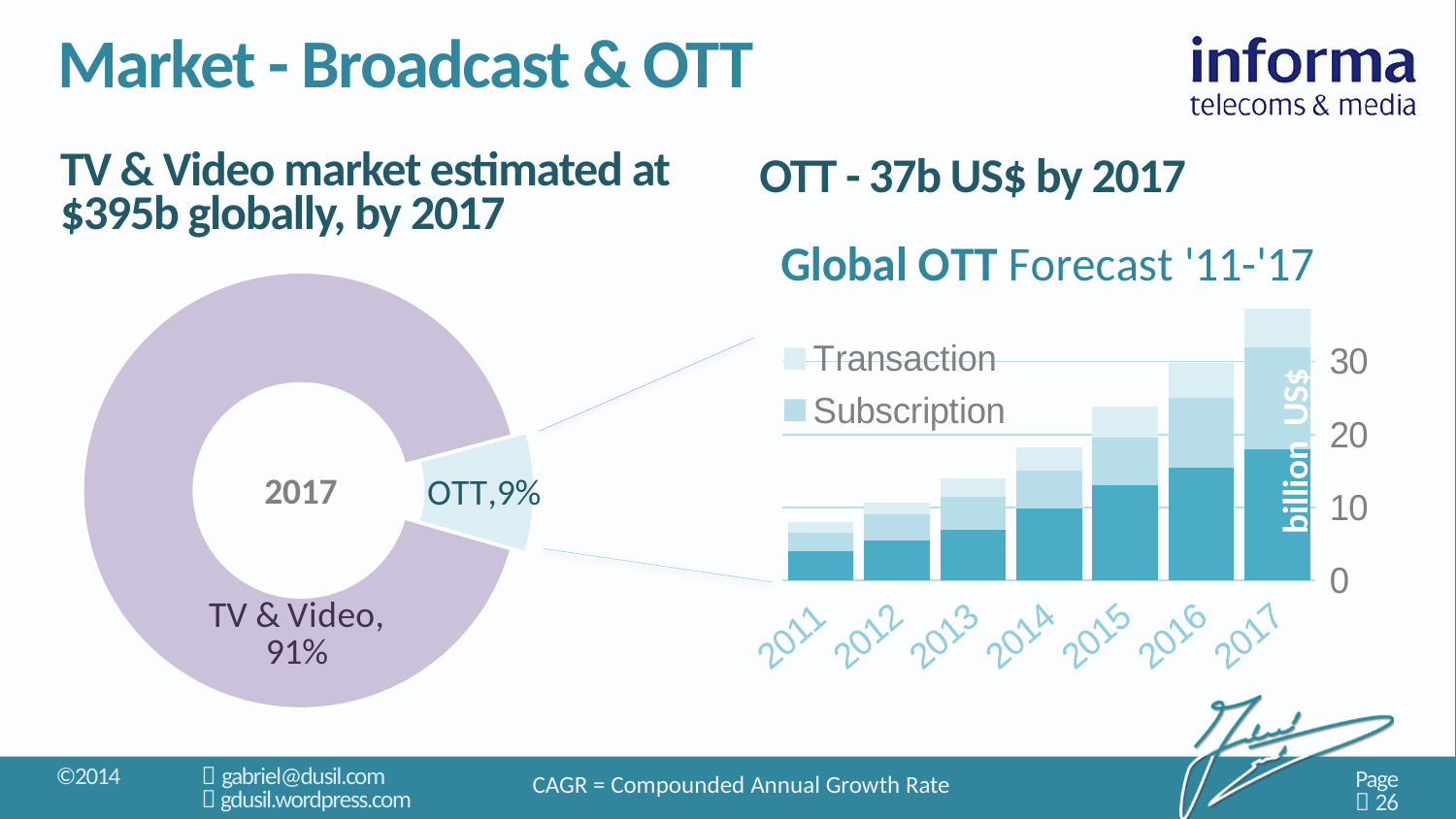
In the Global OTT Forecast '11-'17 chart, which year has the highest total bar? 2017 How many years are shown on the x axis of the Global OTT Forecast '11-'17 chart? 7 In the Global OTT Forecast '11-'17 chart, which year has the lowest total bar? 2011 In the Global OTT Forecast '11-'17 chart, is the total value for 2011 greater or less than 10? less On the donut chart on the left, which slice is larger, OTT or TV & Video? TV & Video On the donut chart on the left, what share of the 2017 market is OTT? 9% In the Global OTT Forecast '11-'17 chart, do the total bar heights rise or fall from 2011 to 2017? Rise In the Global OTT Forecast '11-'17 chart, is the total value for 2017 greater or less than 30? greater What kind of chart is the Global OTT Forecast '11-'17 chart? Stacked bar chart What kind of chart is the chart on the left of the slide? Pie (donut) chart How many series does the legend of the Global OTT Forecast '11-'17 chart list? 2 On the donut chart on the left, what share of the 2017 market is TV & Video? 91%